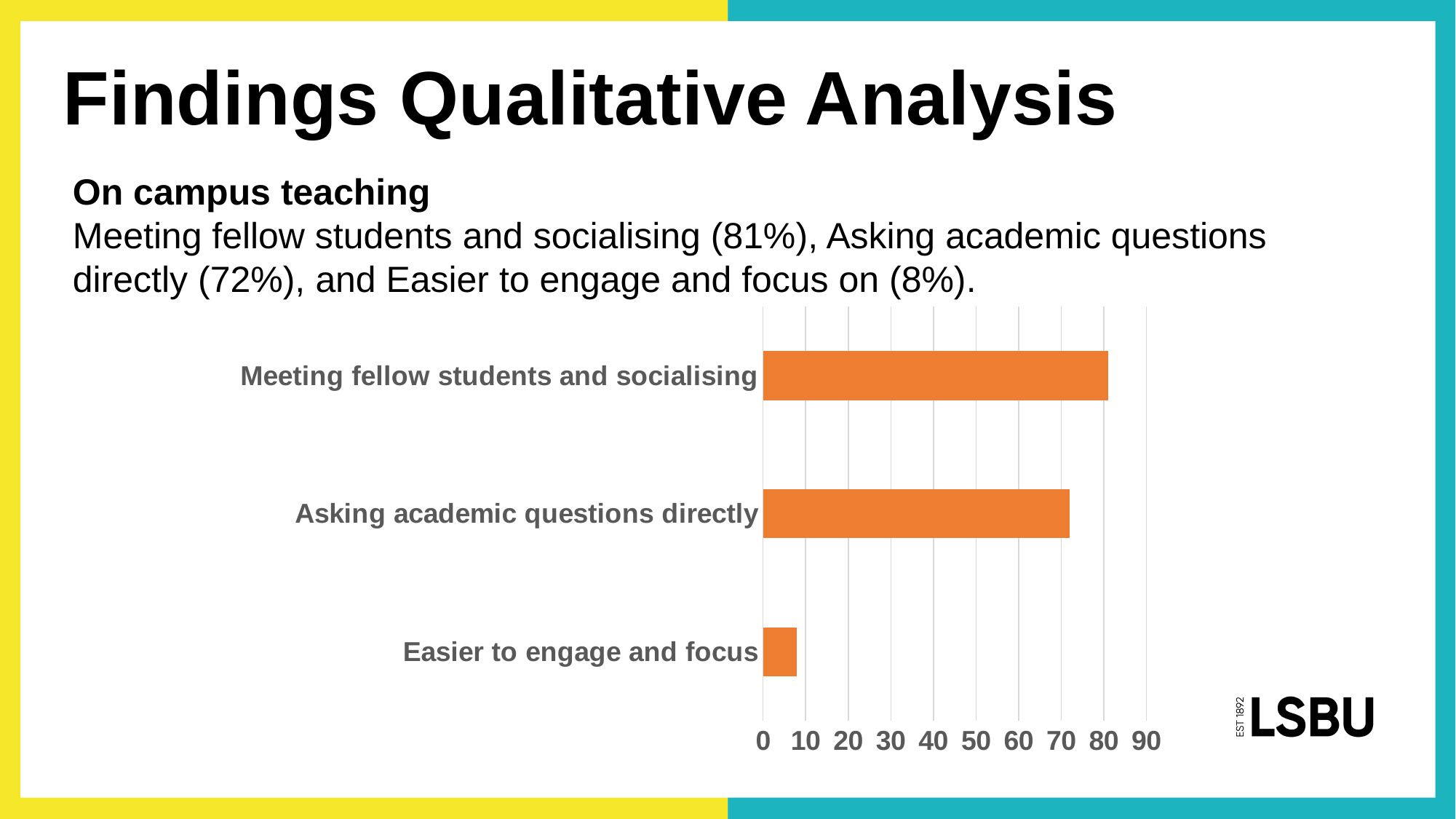
What is the highest tick value shown on the horizontal axis of the bar chart? 90 How many categories does the bar chart show? 3 Is the value for Easier to engage and focus greater or less than 10? less Is the value for Asking academic questions directly greater or less than 80? less Which category has the highest value in the bar chart? Meeting fellow students and socialising Which is larger: the value for Meeting fellow students and socialising or the value for Asking academic questions directly? Meeting fellow students and socialising Which is larger: the value for Easier to engage and focus or the value for Asking academic questions directly? Asking academic questions directly Is the value for Asking academic questions directly greater or less than 70? greater What kind of chart is shown on the slide? bar chart What colour are the bars in the chart? orange Which category has the lowest value in the bar chart? Easier to engage and focus